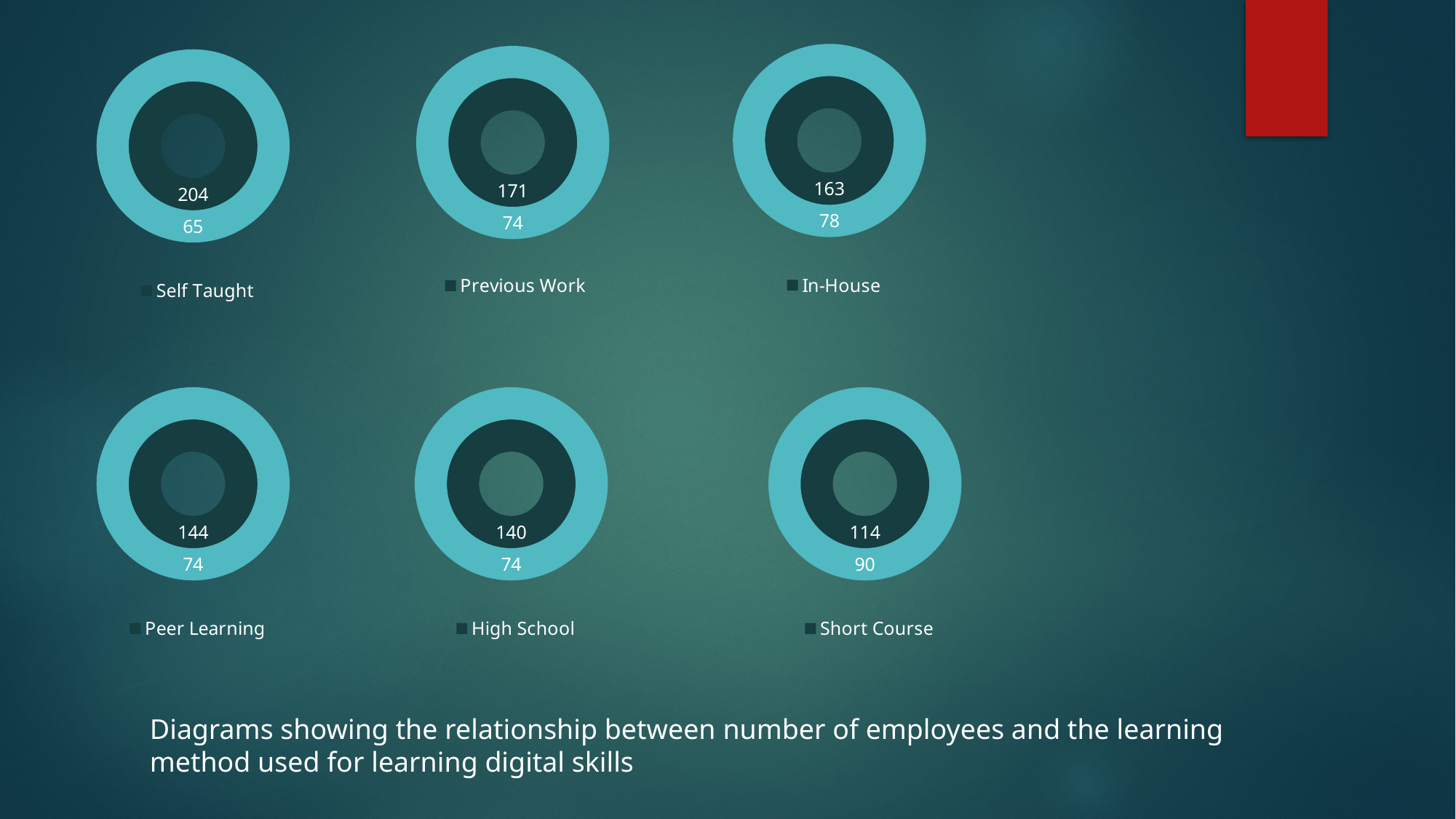
Across the six charts, which learning method has the highest inner ring value? Self Taught On the Short Course chart, what value is labelled on the light outer ring? 90 Which chart has the larger inner ring value, Peer Learning or High School? Peer Learning On the In-House chart, what value is labelled on the light outer ring? 78 What kind of chart is used for each learning method on this slide? Doughnut chart How many doughnut charts are shown on the slide? 6 On the Self Taught chart, what value is labelled on the dark inner ring? 204 On the Self Taught chart, what is the difference between the inner ring value and the outer ring value? 139 What is the legend entry of the chart in the bottom-right position? Short Course On the Previous Work chart, what value is labelled on the dark inner ring? 171 On the Short Course chart, what value is labelled on the dark inner ring? 114 On the Self Taught chart, what value is labelled on the light outer ring? 65